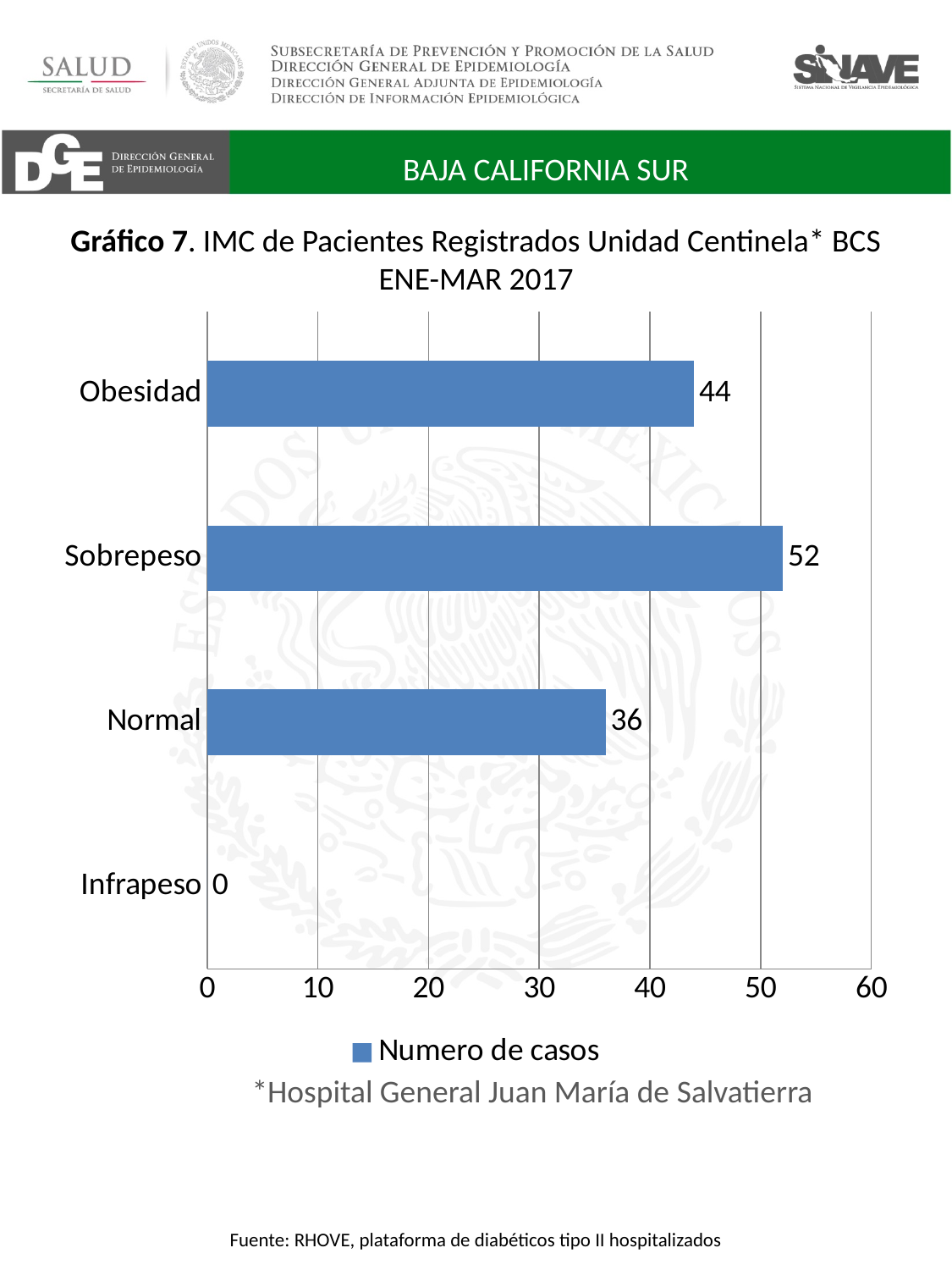
Which category has the highest number of cases? Sobrepeso What is the value for Obesidad? 44 What is the value for Sobrepeso? 52 What series name does the legend show? Numero de casos What is the value for Infrapeso? 0 How many categories are shown on the chart? 4 What kind of chart is shown on the slide? bar chart Which category has the lowest number of cases? Infrapeso What is the value for Normal? 36 Is the value for Sobrepeso greater or less than 50? greater What is the difference between the values for Sobrepeso and Obesidad? 8 Which is larger, the value for Obesidad or the value for Normal? Obesidad